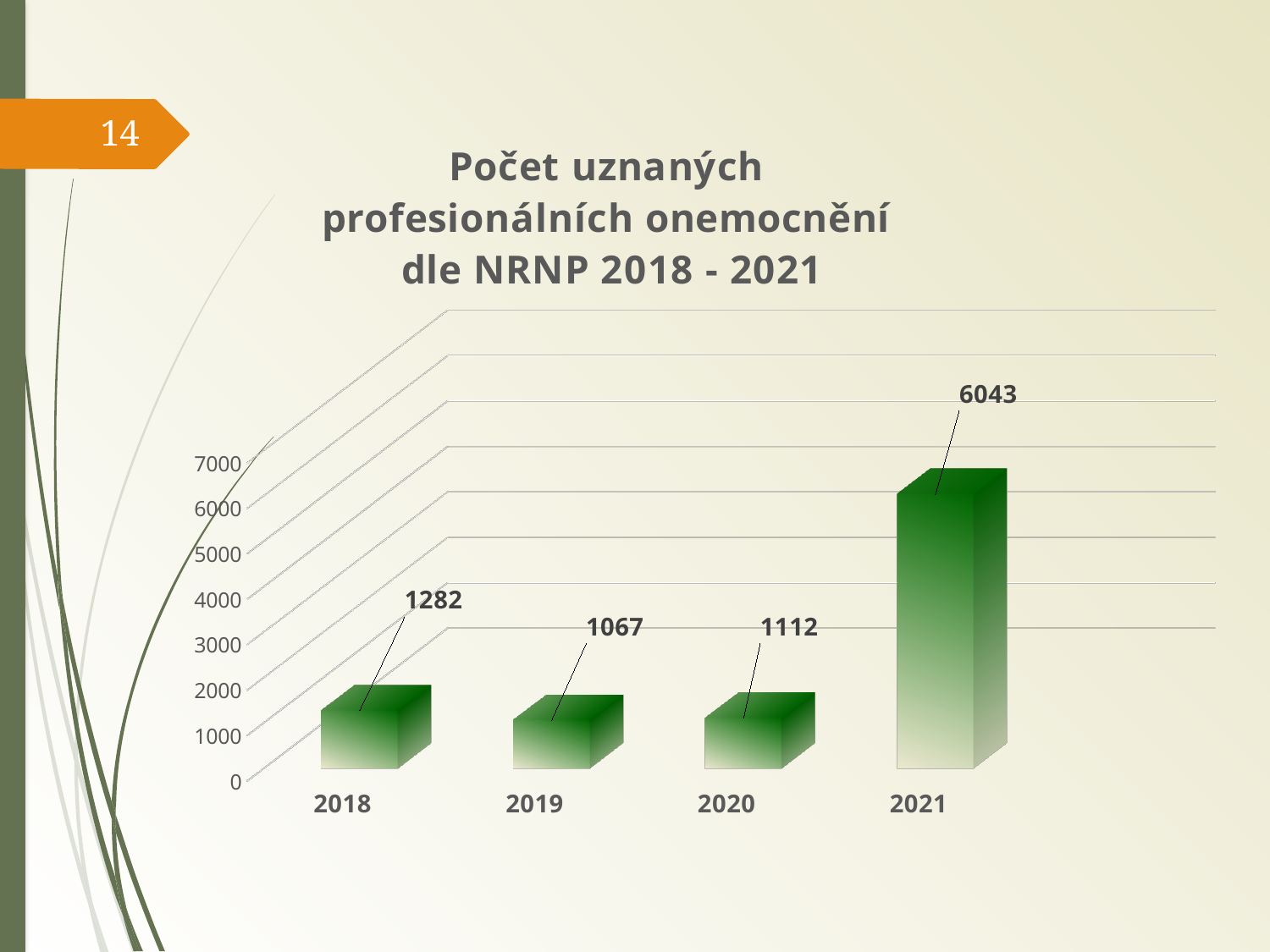
What is the difference between the values for 2021 and 2018? 4761 Which is larger, the value for 2018 or the value for 2020? 2018 What is the value for 2021? 6043 What kind of chart is shown on the slide? bar chart What is the difference between the values for 2020 and 2019? 45 How many years are shown on the x axis? 4 Which year has the highest value? 2021 What is the value for 2019? 1067 Is the value for 2021 greater or less than 5000? greater What is the value for 2018? 1282 Which year has the lowest value? 2019 What is the value for 2020? 1112